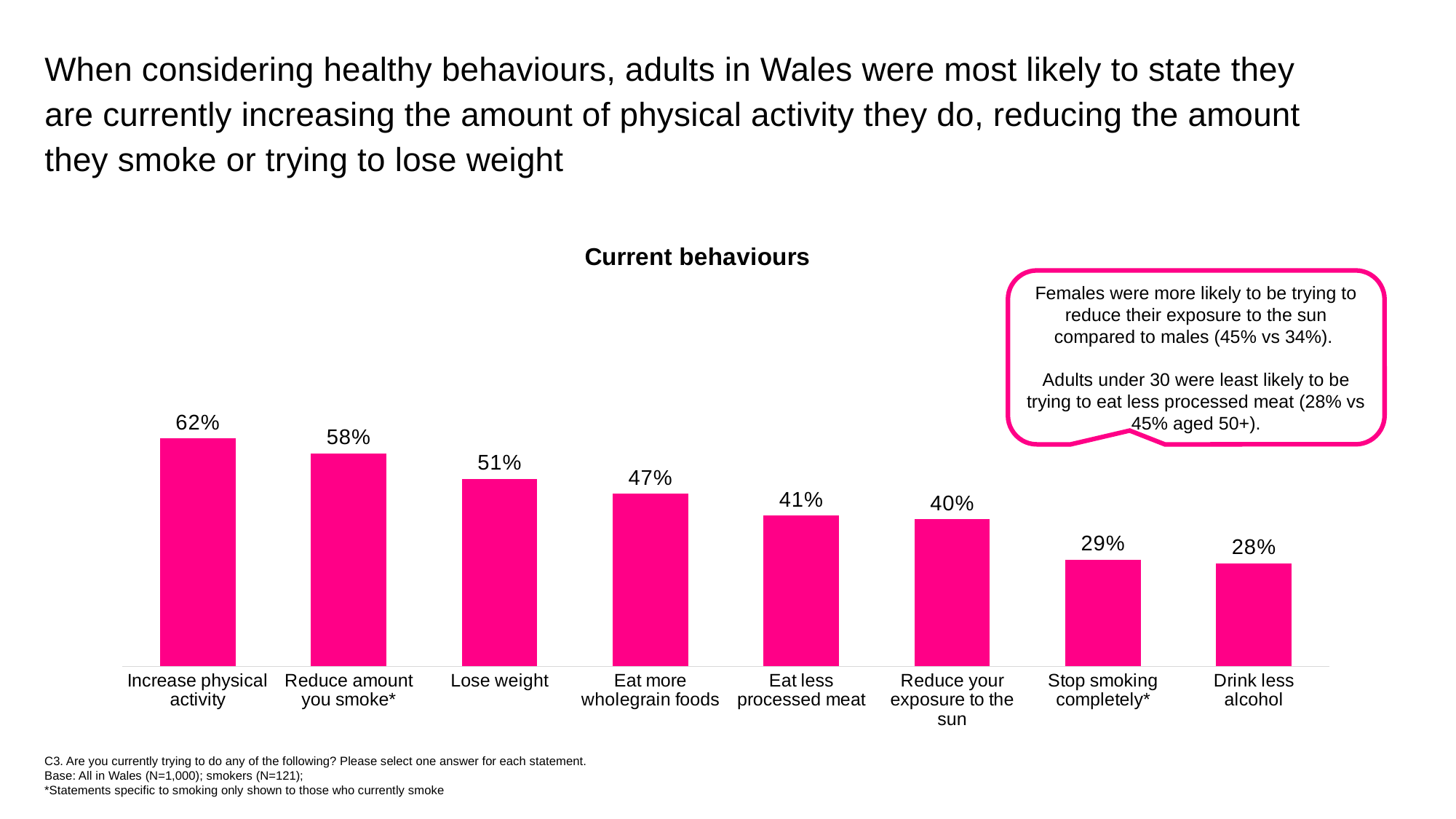
What is the difference between 'Reduce amount you smoke*' and 'Stop smoking completely*'? 29 percentage points Which behaviour has the highest percentage in the chart? Increase physical activity Which behaviour has the lowest percentage in the chart? Drink less alcohol What is the difference between the values for 'Increase physical activity' and 'Lose weight'? 11 percentage points What percentage of adults in Wales are currently trying to increase physical activity? 62% What is the value shown for 'Reduce your exposure to the sun'? 40% What is the value shown for 'Eat less processed meat'? 41% What is the title of the chart? Current behaviours Which is larger: the value for 'Eat more wholegrain foods' or 'Eat less processed meat'? Eat more wholegrain foods What type of chart is used to show current behaviours? Bar chart How many behaviours (categories) are shown in the chart? 8 Do the values rise or fall moving from left to right across the chart? Fall